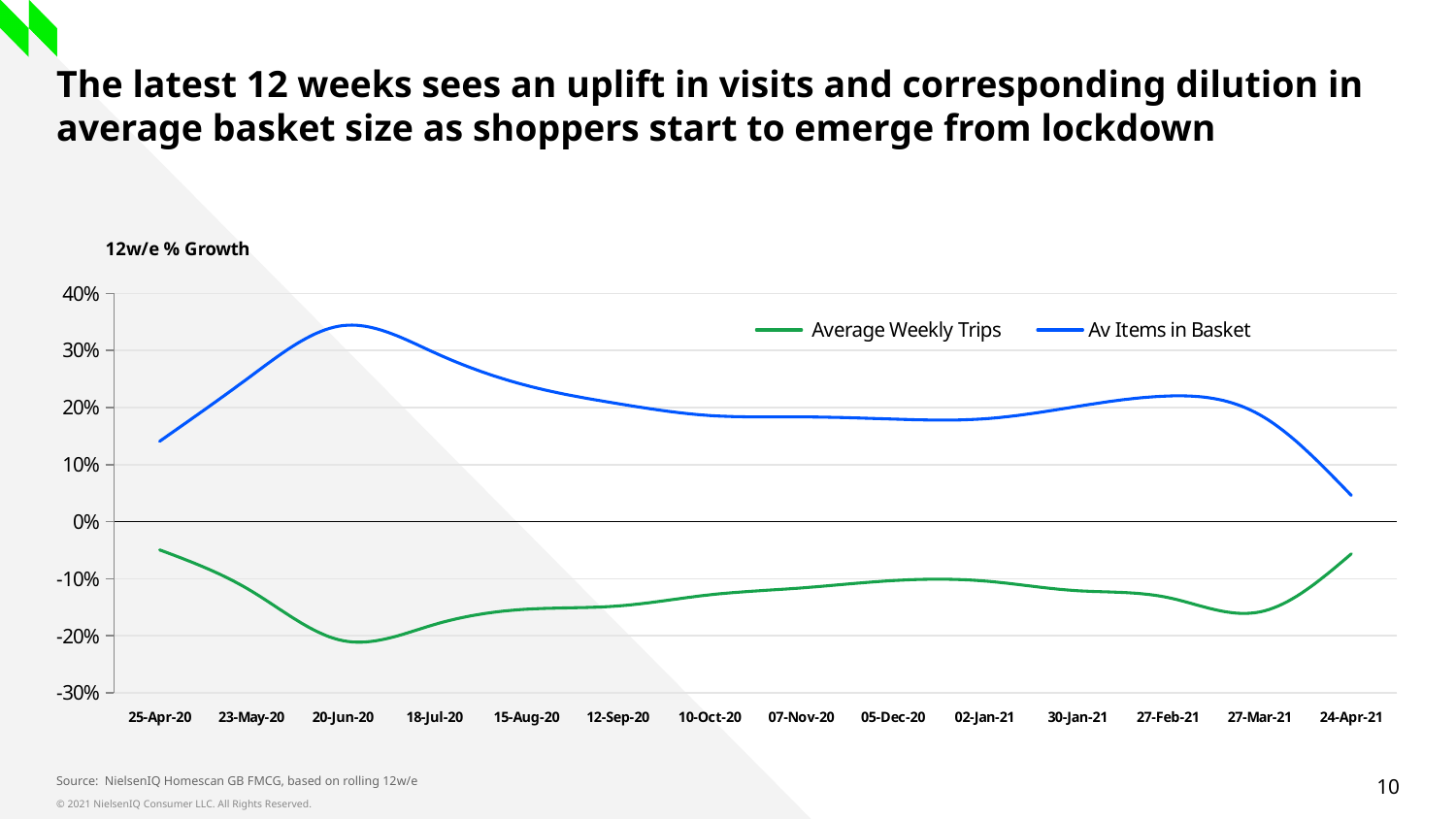
Does the Av Items in Basket series rise or fall between 27-Feb-21 and 24-Apr-21? Fall Is the value for Av Items in Basket at 24-Apr-21 greater or less than 10%? less At which date does the Average Weekly Trips series reach its lowest value? 20-Jun-20 Which is larger for Average Weekly Trips: the value at 05-Dec-20 or the value at 27-Mar-21? 05-Dec-20 At which date does the Av Items in Basket series reach its highest value? 20-Jun-20 Is the value for Average Weekly Trips at 05-Dec-20 greater or less than -20%? greater Is the value for Av Items in Basket at 20-Jun-20 greater or less than 30%? greater What kind of chart is shown on the slide? Line chart How many series does the legend list? 2 How many dates are shown along the x axis? 14 What is the title of the chart? 12w/e % Growth At which date does the Av Items in Basket series reach its lowest value? 24-Apr-21